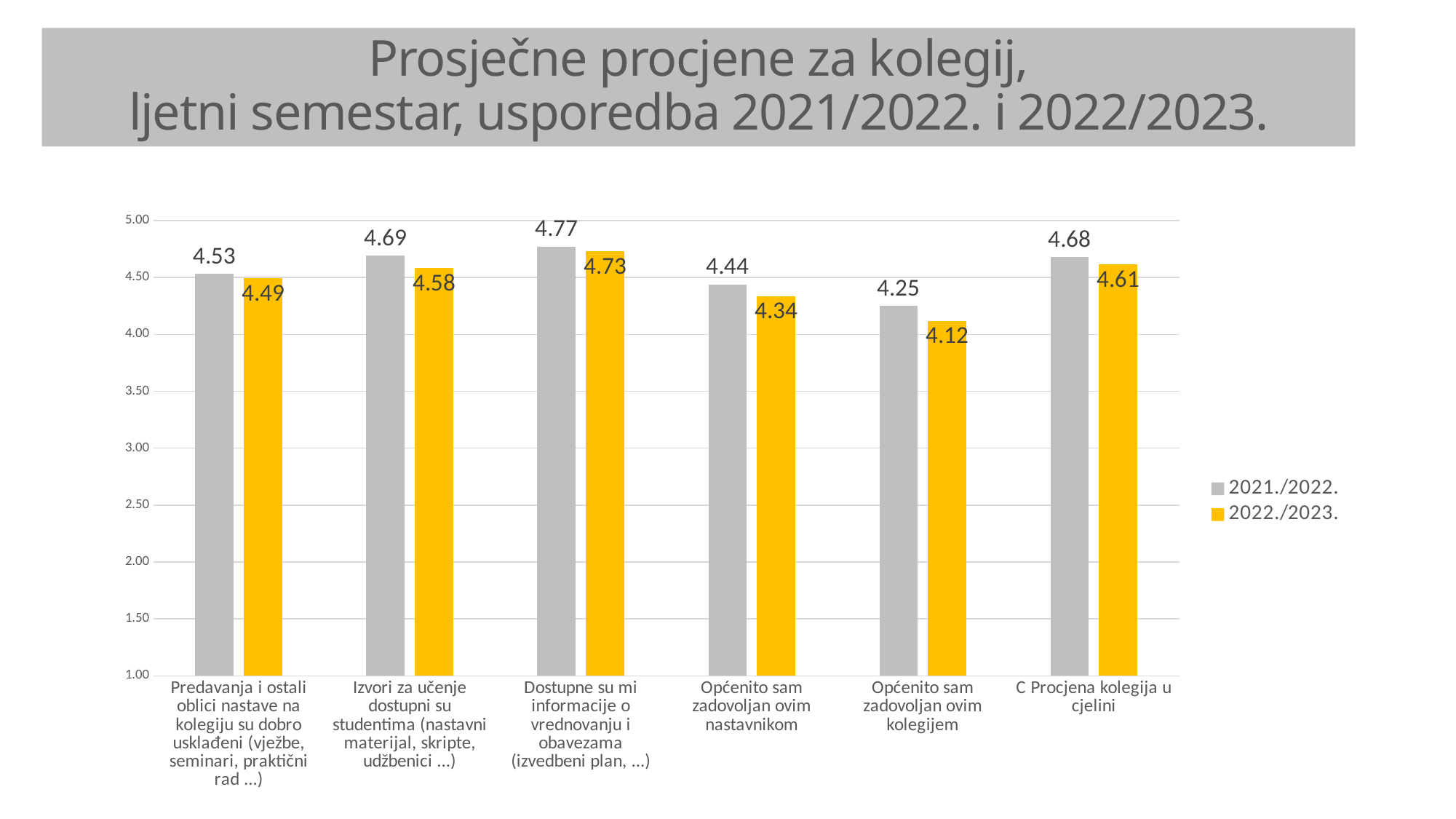
What is the difference between the 2021./2022. and 2022./2023. values for "Izvori za učenje dostupni su studentima (nastavni materijal, skripte, udžbenici ...)"? 0.11 For "C Procjena kolegija u cjelini", which series has the larger value, 2021./2022. or 2022./2023.? 2021./2022. What is the 2022./2023. value for "Općenito sam zadovoljan ovim kolegijem"? 4.12 How many categories are shown on the x axis? 6 How many series does the legend list? 2 What kind of chart is shown on the slide? Bar chart What is the difference between the 2021./2022. and 2022./2023. values for "Općenito sam zadovoljan ovim kolegijem"? 0.13 Which colour represents the 2022./2023. series in the legend? Yellow What is the 2022./2023. value for "C Procjena kolegija u cjelini"? 4.61 Which category has the highest 2021./2022. value? Dostupne su mi informacije o vrednovanju i obavezama (izvedbeni plan, ...) Which category has the lowest 2022./2023. value? Općenito sam zadovoljan ovim kolegijem What is the 2021./2022. value for "Općenito sam zadovoljan ovim nastavnikom"? 4.44